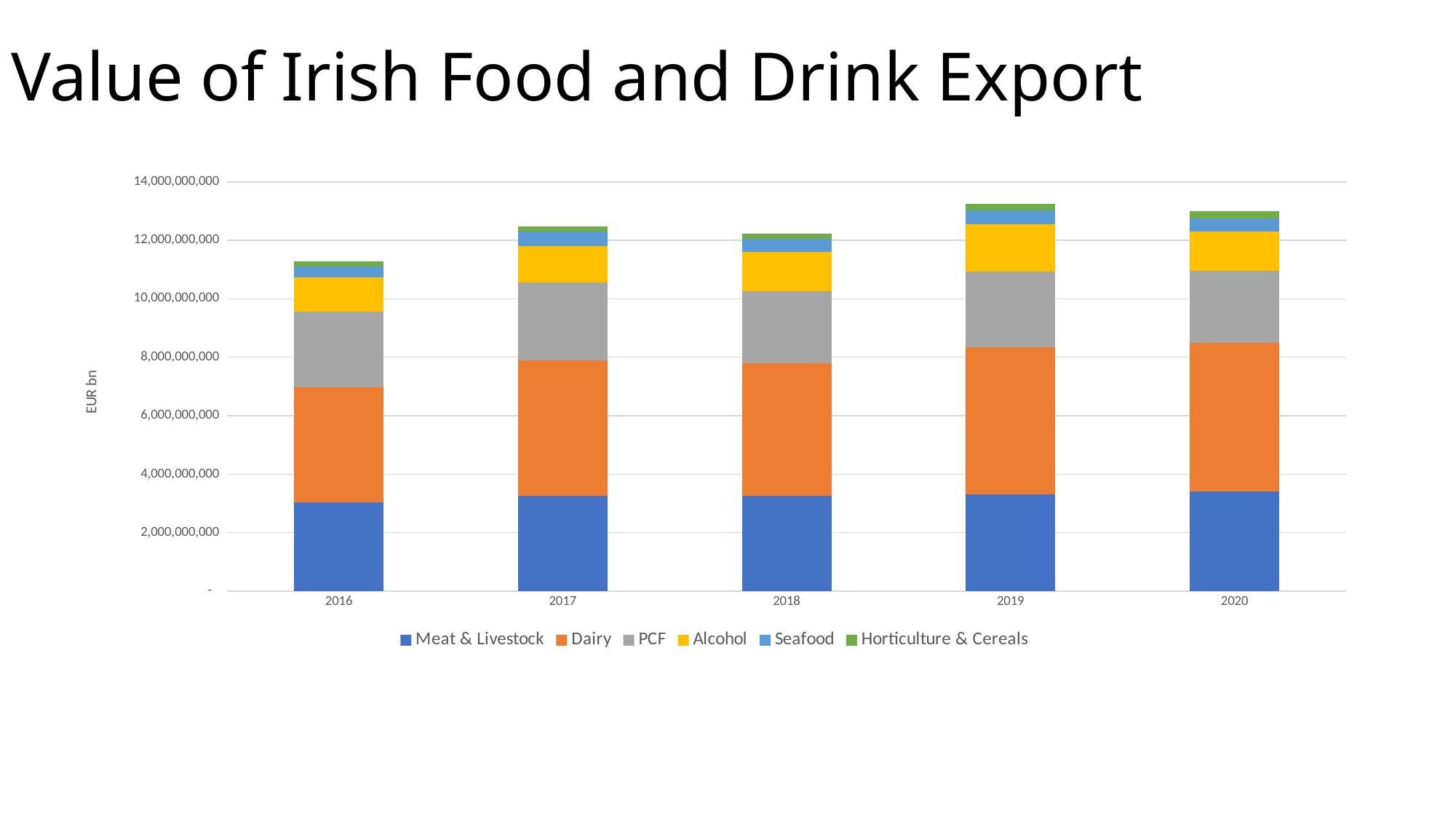
Is the total export value for 2017 greater or less than 14,000,000,000? less Does the total export value rise or fall from 2016 to 2019? rise Which year has the lowest total export value in the chart? 2016 How many years are shown on the x axis of the chart? 5 In 2020, which is larger: the Dairy segment or the Meat & Livestock segment? Dairy What kind of chart is shown on the slide? Stacked bar chart Is the total export value for 2019 greater or less than 12,000,000,000? greater What is the title of the chart on the slide? Value of Irish Food and Drink Export Is the Meat & Livestock value for 2016 greater or less than 4,000,000,000? less How many series does the chart's legend list? 6 What is the label on the vertical axis of the chart? EUR bn